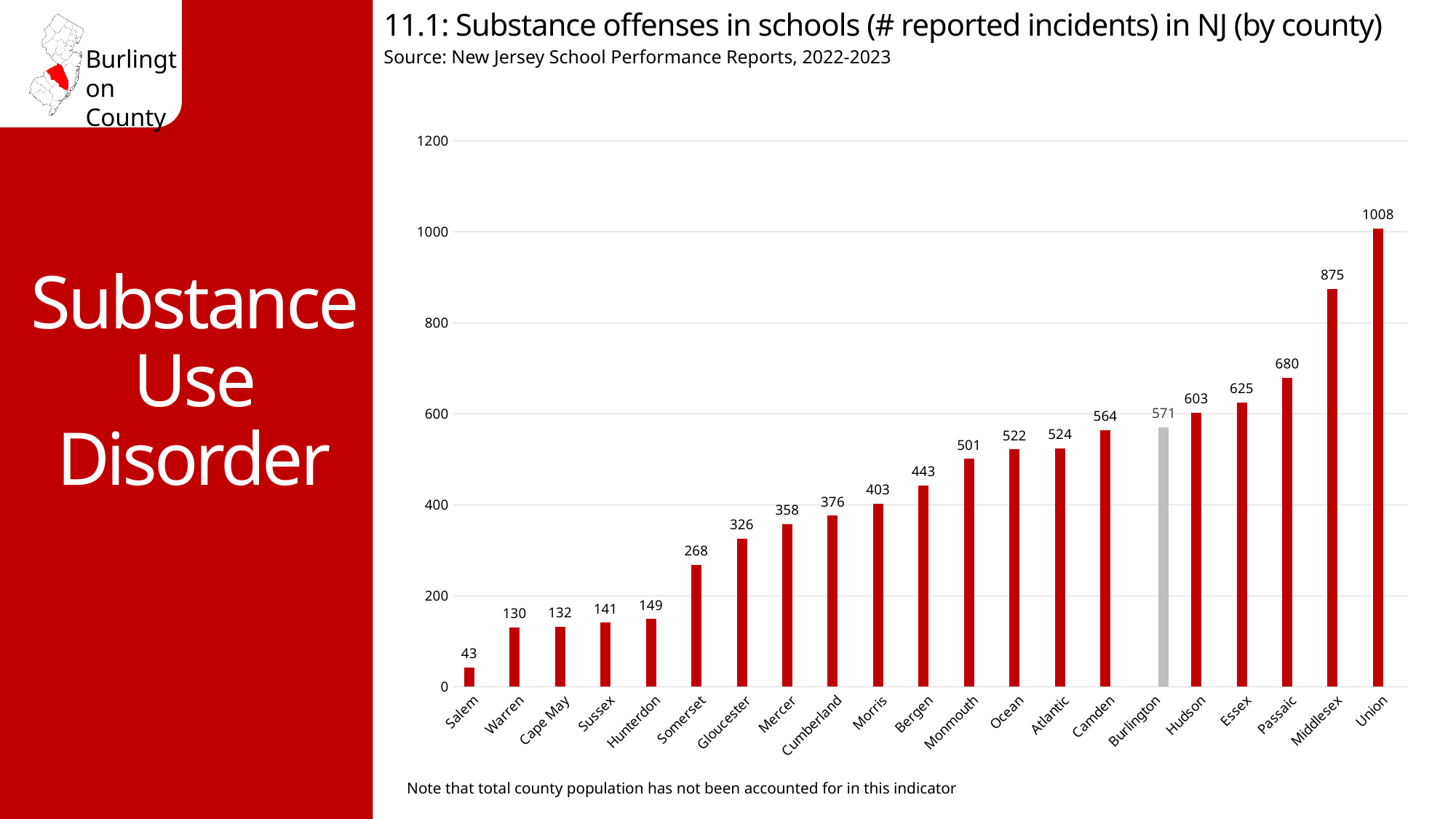
Which has a higher value, Hudson or Essex? Essex What is the difference between the values for Union and Middlesex? 133 Is the value for Passaic greater or less than 600? greater What is the number of reported substance offense incidents in schools for Burlington County? 571 What is the value shown for Union County? 1008 Which county has the lowest number of reported incidents? Salem How many counties are shown on the chart? 21 What kind of chart is shown on the slide? Bar chart Which county's bar is coloured grey instead of red? Burlington Which county has the highest number of reported incidents? Union What is the value shown for Gloucester County? 326 What is the difference between the values for Burlington and Camden? 7